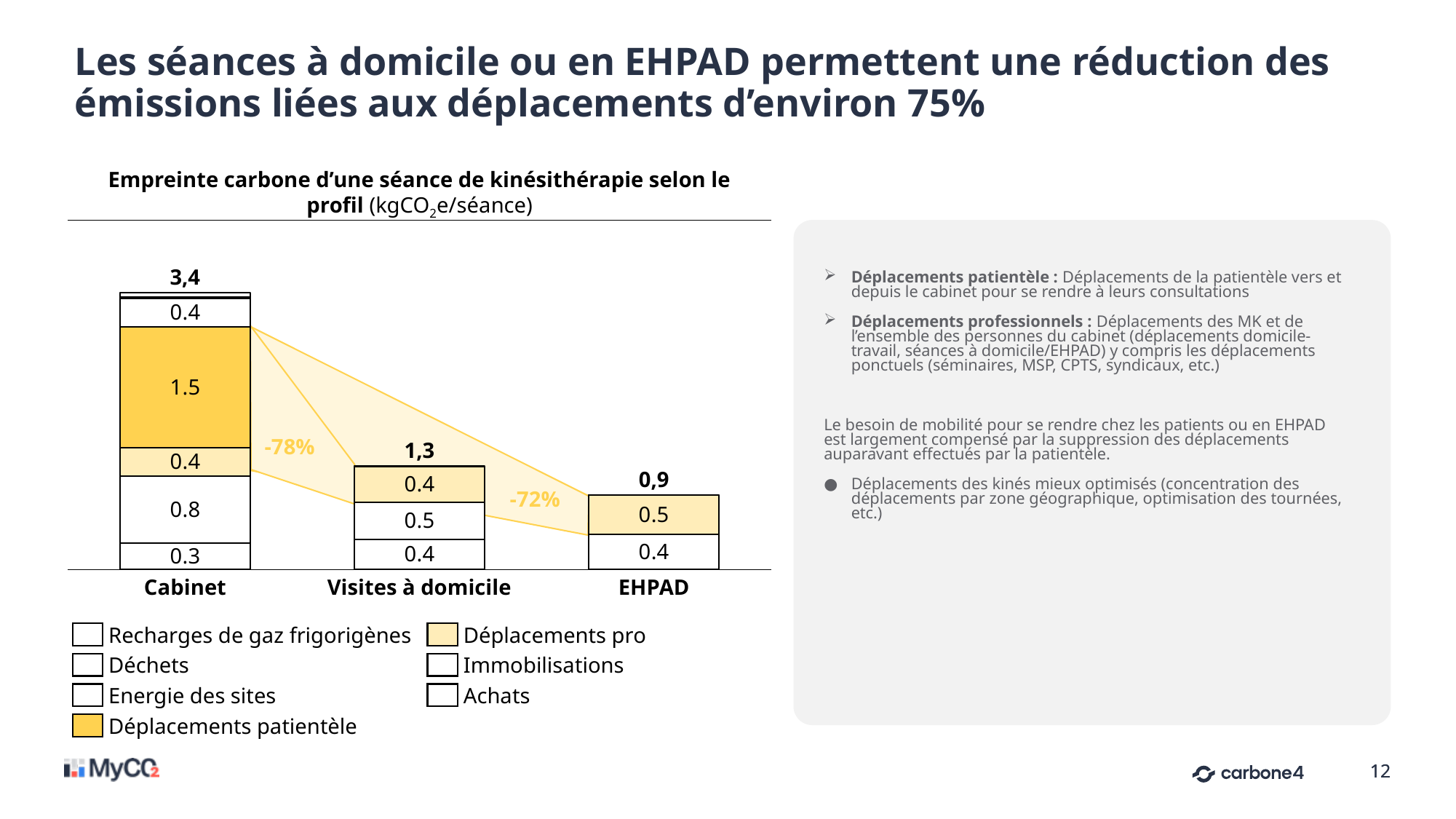
What is the total carbon footprint shown for the EHPAD profile? 0,9 What kind of chart is shown on the slide? Stacked bar chart Which profile has the highest total carbon footprint per session? Cabinet What is the total carbon footprint shown for the Cabinet profile? 3,4 What is the value of the Déplacements pro segment for the EHPAD profile? 0.5 What is the value of the Déplacements patientèle segment for the Cabinet profile? 1.5 How many series does the legend list? 7 Which profile has the lowest total carbon footprint per session? EHPAD What is the total carbon footprint shown for the Visites à domicile profile? 1,3 What percentage reduction is labelled between the Cabinet bar and the Visites à domicile bar? -78% What is the difference between the total for Cabinet and the total for EHPAD? 2,5 How many profiles (categories) are shown on the x axis? 3